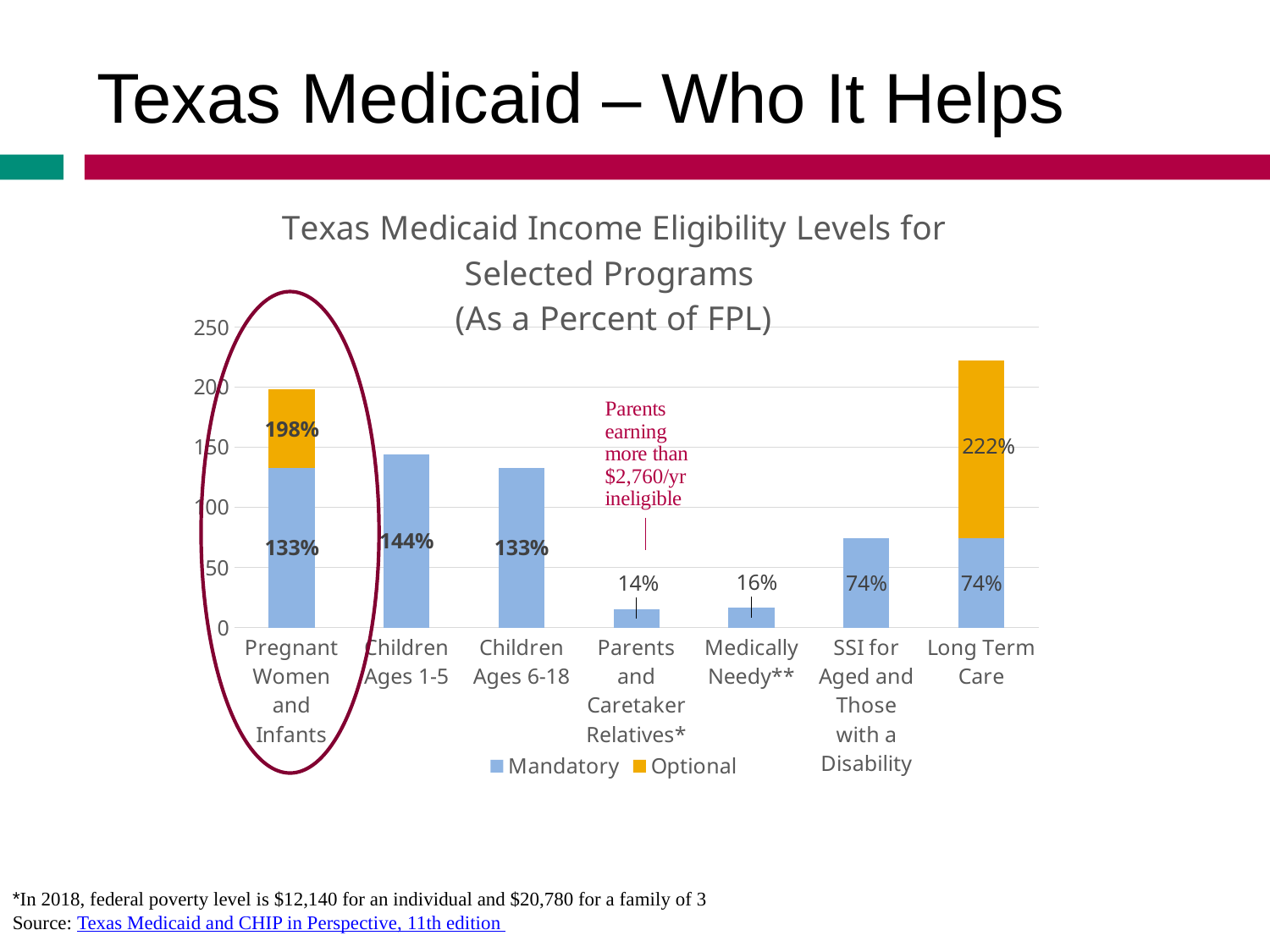
Is the total value for Long Term Care greater or less than 200? greater What is the Mandatory value for Long Term Care? 74% Which category has the lowest eligibility level? Parents and Caretaker Relatives* How many series does the legend list? 2 How many program categories are shown on the x axis? 7 What is the total eligibility level shown at the top of the Long Term Care bar? 222% What is the income eligibility level for Children Ages 1-5? 144% What kind of chart is shown on the slide? bar chart What is the difference between the values for Children Ages 1-5 and Children Ages 6-18? 11% What is the value shown for Parents and Caretaker Relatives*? 14% Which category has the tallest bar overall? Long Term Care What is the total eligibility level shown for Pregnant Women and Infants? 198%